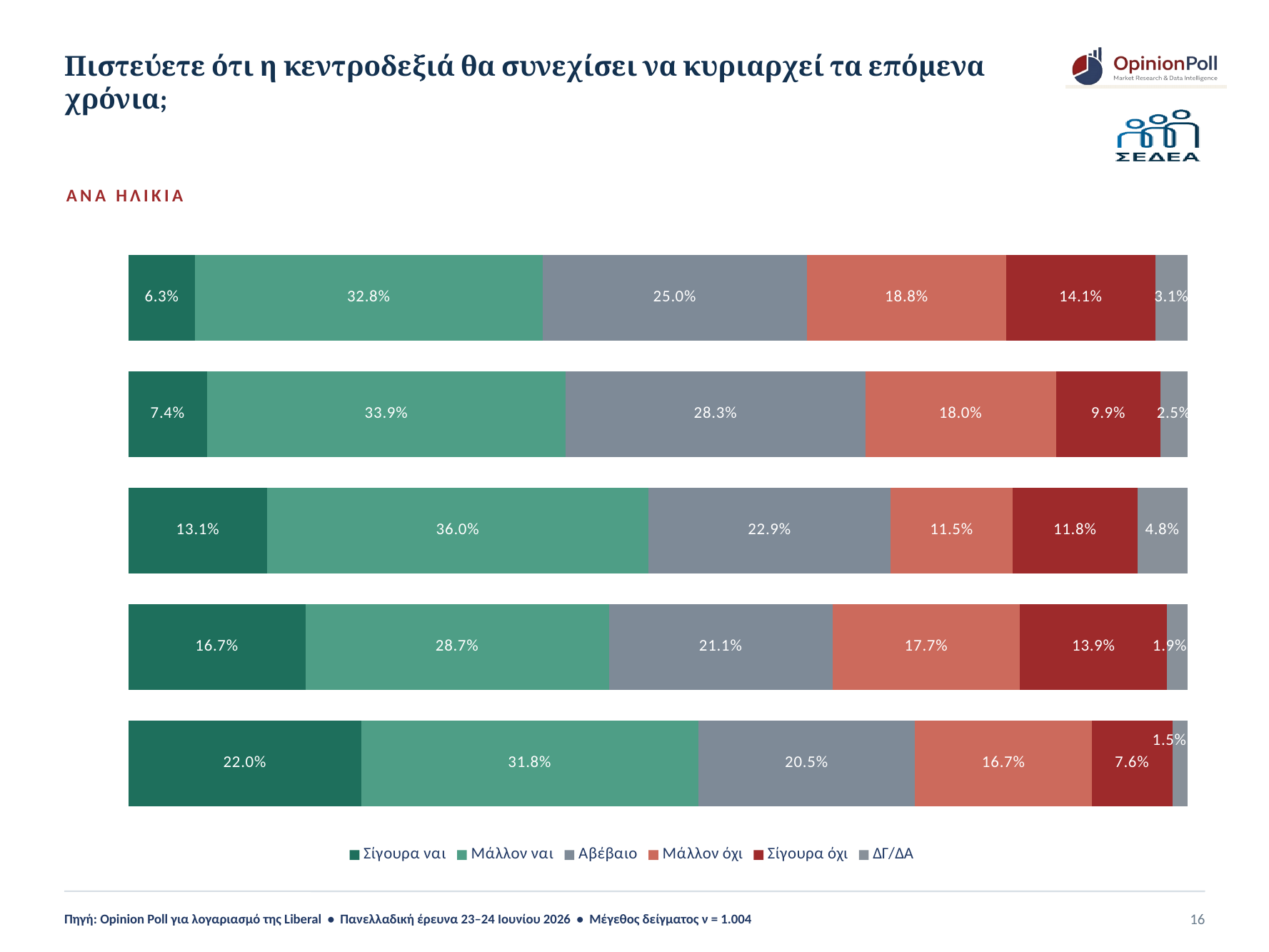
What is the value of Σίγουρα ναι in the bottom bar? 22.0% Which bar has the highest value for Σίγουρα ναι? The bottom bar (22.0%) How many series does the legend list? 6 Which bar has the lowest value for ΔΓ/ΔΑ? The bottom bar (1.5%) What is the value of Αβέβαιο in the second bar from the top? 28.3% What is the combined value of Σίγουρα ναι and Μάλλον ναι in the bottom bar? 53.8% What kind of chart is shown on the slide? Stacked bar chart How many bars are plotted in the chart? 5 Which bar has the highest value for Μάλλον ναι? The third bar from the top (36.0%) In the top bar, how much larger is Μάλλον ναι than Σίγουρα ναι? 26.5 percentage points In the third bar from the top, which is larger: Μάλλον όχι or Σίγουρα όχι? Σίγουρα όχι What is the value of Σίγουρα όχι in the fourth bar from the top? 13.9%